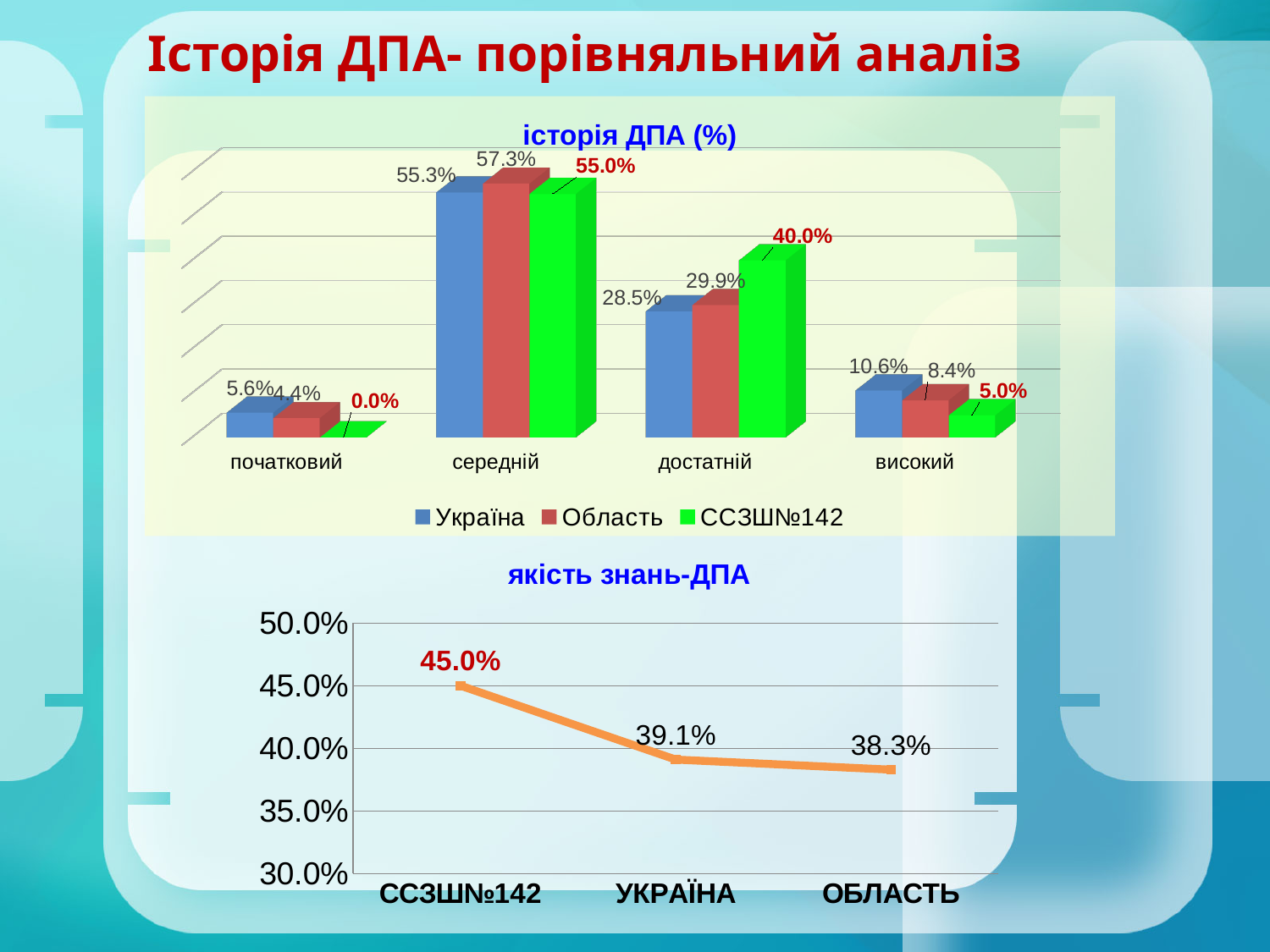
In the chart titled "історія ДПА (%)", how many series does the legend list? 3 In the chart titled "якість знань-ДПА", what is the difference between ССЗШ№142 and ОБЛАСТЬ? 6.7% In the chart titled "історія ДПА (%)", which series has the lowest value in the початковий category? ССЗШ№142 In the chart titled "історія ДПА (%)", what is the value for Область in the середній category? 57.3% In the chart titled "історія ДПА (%)", what is the value for Україна in the високий category? 10.6% In the chart titled "історія ДПА (%)", which is larger in the високий category: Область or ССЗШ№142? Область In the chart titled "якість знань-ДПА", what is the value for УКРАЇНА? 39.1% In the chart titled "історія ДПА (%)", how many categories are shown on the x axis? 4 In the chart titled "історія ДПА (%)", which category has the highest value for Україна? середній In the chart titled "історія ДПА (%)", what is the difference between ССЗШ№142 and Україна in the достатній category? 11.5% In the chart titled "якість знань-ДПА", do the values rise or fall from left to right along the x axis? fall In the chart titled "історія ДПА (%)", what is the value for ССЗШ№142 in the достатній category? 40.0%